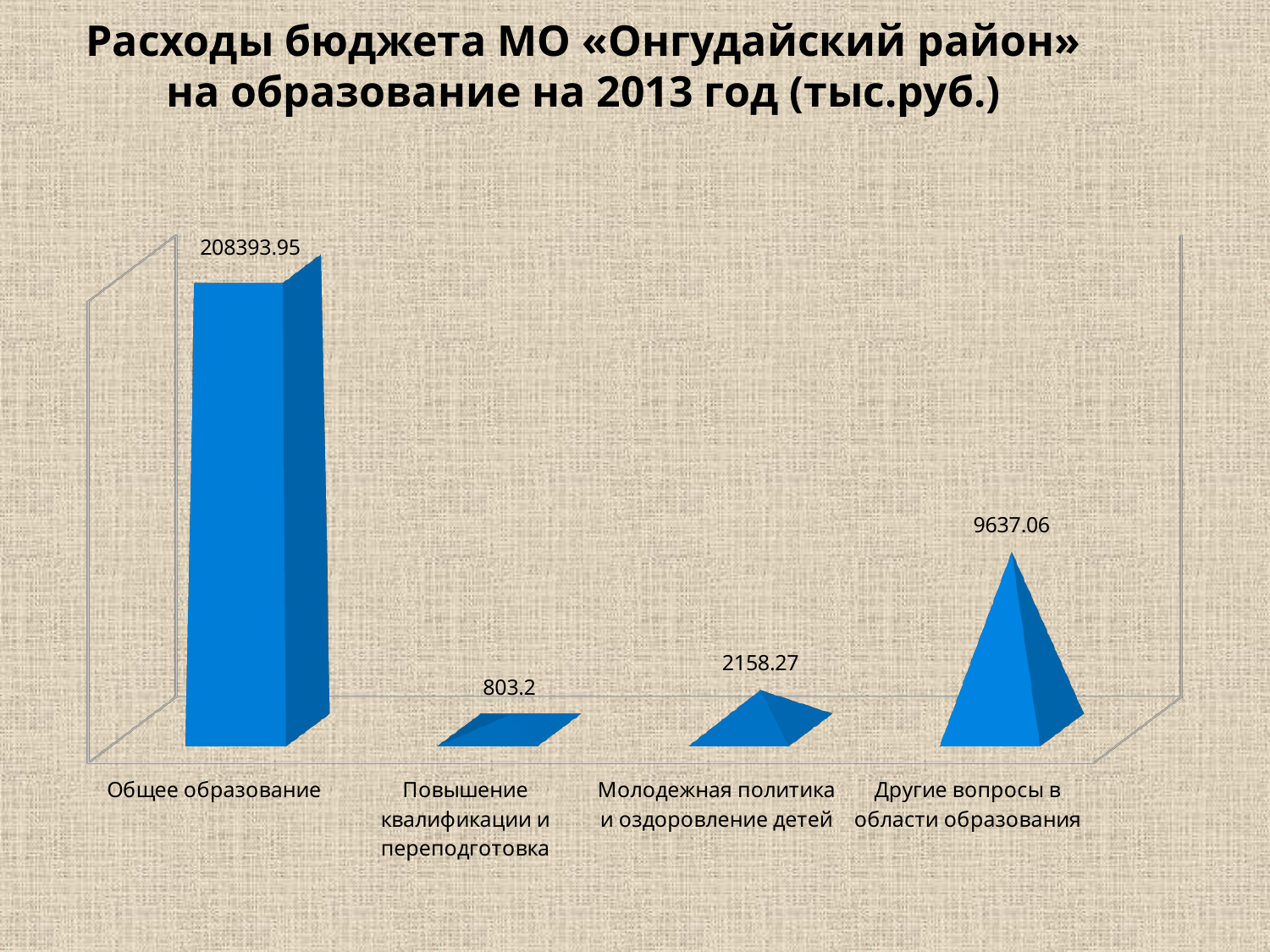
How many categories are shown in the chart? 4 What kind of chart is shown on the slide? Bar chart Which category has the highest value? Общее образование What is the difference between the values for Молодежная политика и оздоровление детей and Повышение квалификации и переподготовка? 1355.07 What is the value for Другие вопросы в области образования? 9637.06 What is the value for Молодежная политика и оздоровление детей? 2158.27 Which category has the lowest value? Повышение квалификации и переподготовка Which is larger: the value for Другие вопросы в области образования or the value for Молодежная политика и оздоровление детей? Другие вопросы в области образования What is the difference between the values for Общее образование and Другие вопросы в области образования? 198756.89 What is the title of the chart? Расходы бюджета МО «Онгудайский район» на образование на 2013 год (тыс.руб.) What is the value for Повышение квалификации и переподготовка? 803.2 What is the value for Общее образование? 208393.95